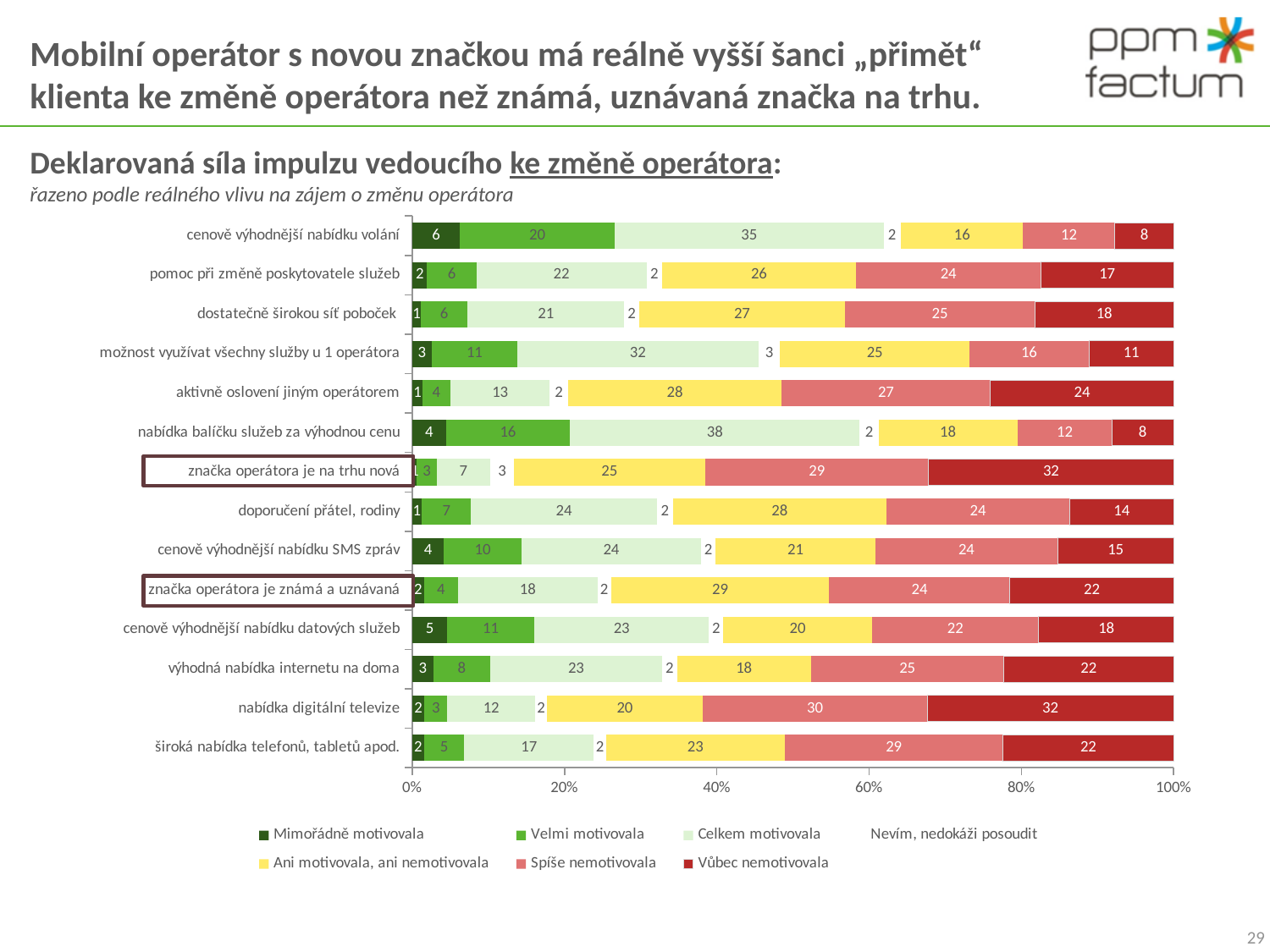
What is the value of "Spíše nemotivovala" for "široká nabídka telefonů, tabletů apod."? 29 Which category has the highest value for "Celkem motivovala"? nabídka balíčku služeb za výhodnou cenu How many series does the legend list? 7 How many categories are shown on the chart? 14 Which category has the lowest value for "Celkem motivovala"? značka operátora je na trhu nová What is the value of "Vůbec nemotivovala" for "značka operátora je na trhu nová"? 32 What kind of chart is shown on the slide? stacked bar chart What is the value of "Celkem motivovala" for "nabídka balíčku služeb za výhodnou cenu"? 38 Which category has the highest value for "Velmi motivovala"? cenově výhodnější nabídku volání What is the value of "Ani motivovala, ani nemotivovala" for "značka operátora je známá a uznávaná"? 29 What is the difference between the "Vůbec nemotivovala" values for "značka operátora je na trhu nová" and "značka operátora je známá a uznávaná"? 10 Which has the larger "Spíše nemotivovala" value: "nabídka digitální televize" or "cenově výhodnější nabídku volání"? nabídka digitální televize